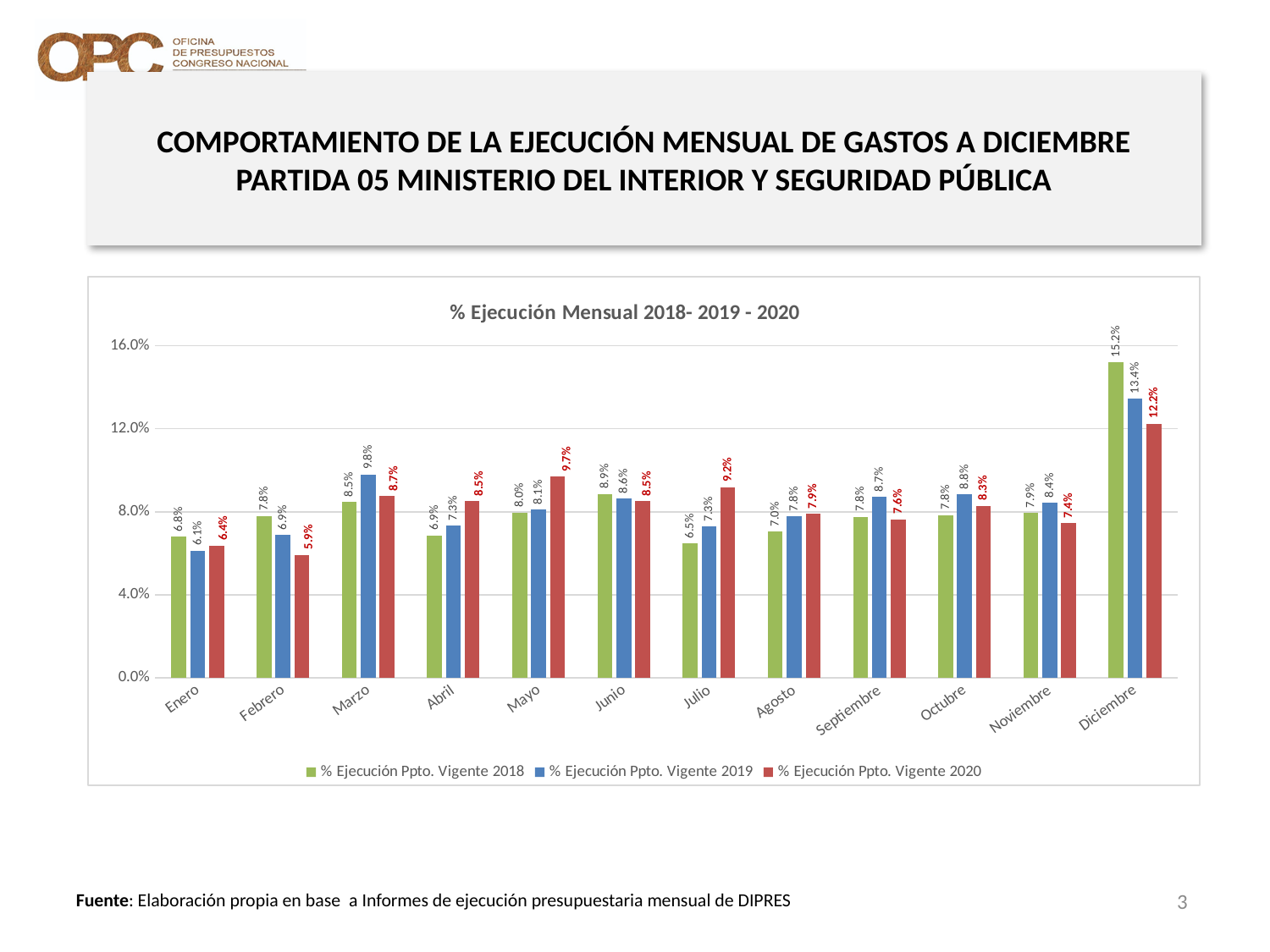
Which month has the lowest value for % Ejecución Ppto. Vigente 2020? Febrero How many series does the legend list? 3 How many months are shown on the x axis? 12 What kind of chart is shown on the slide? Bar chart What is the value for % Ejecución Ppto. Vigente 2019 in Marzo? 9.8% What is the title of the chart? % Ejecución Mensual 2018- 2019 - 2020 Which month has the highest value for % Ejecución Ppto. Vigente 2018? Diciembre Which is larger in Mayo: the 2019 value or the 2020 value? 2020 value (9.7%) What is the value for % Ejecución Ppto. Vigente 2020 in Diciembre? 12.2% Is the value for % Ejecución Ppto. Vigente 2019 in Diciembre greater or less than 12.0%? greater What is the difference between the 2018 and 2020 values in Diciembre? 3.0% What is the value for % Ejecución Ppto. Vigente 2018 in Julio? 6.5%